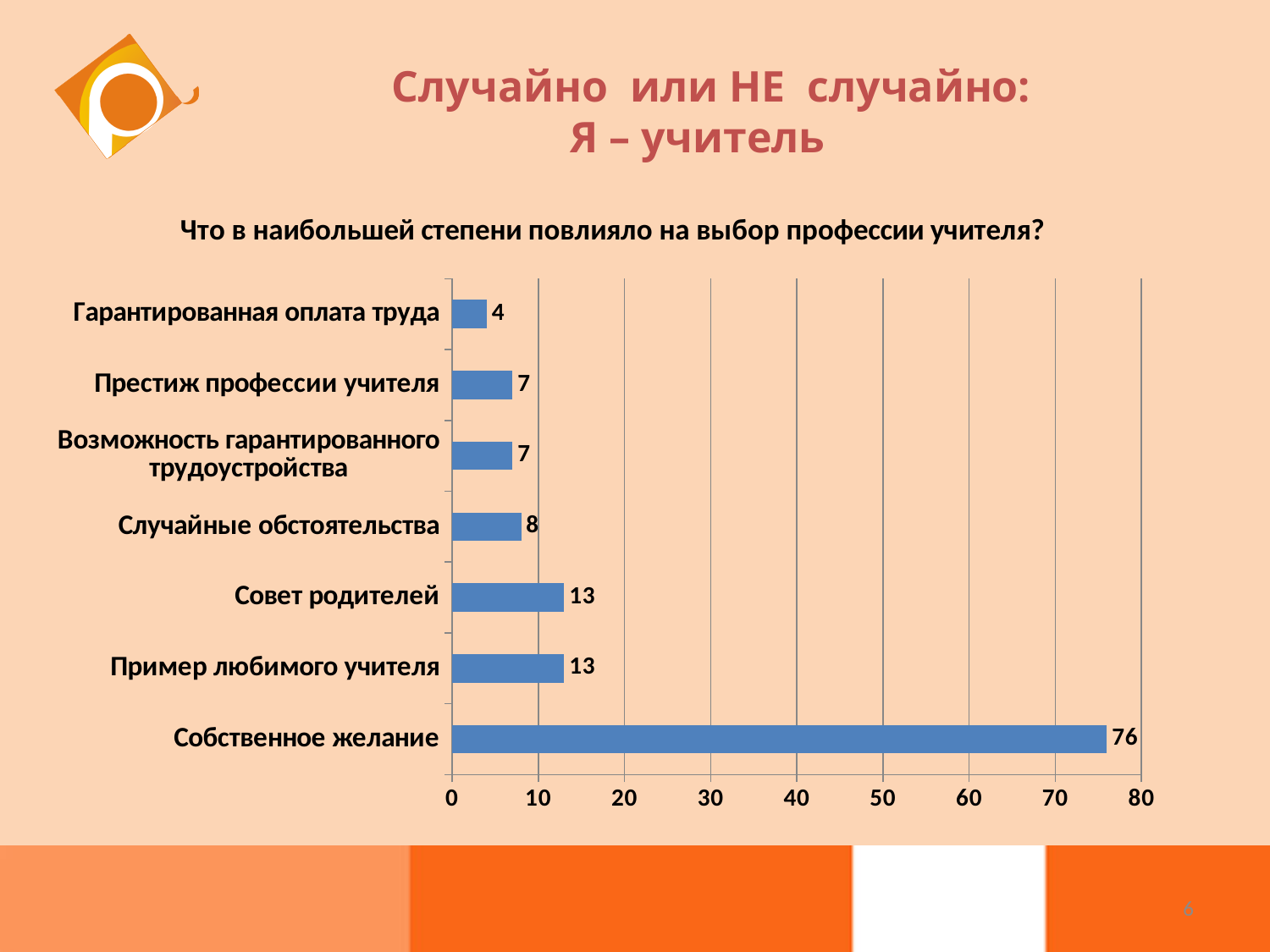
Which category has the highest value? Собственное желание Which category has the lowest value? Гарантированная оплата труда Is the value for Собственное желание greater or less than 70? greater What is the value for Собственное желание? 76 What is the title of the chart? Что в наибольшей степени повлияло на выбор профессии учителя? Which is larger, the value for Случайные обстоятельства or the value for Престиж профессии учителя? Случайные обстоятельства What is the value for Случайные обстоятельства? 8 What is the value for Совет родителей? 13 What kind of chart is shown on the slide? bar chart How many categories are shown in the chart? 7 What is the value for Гарантированная оплата труда? 4 What is the difference between the values for Собственное желание and Пример любимого учителя? 63